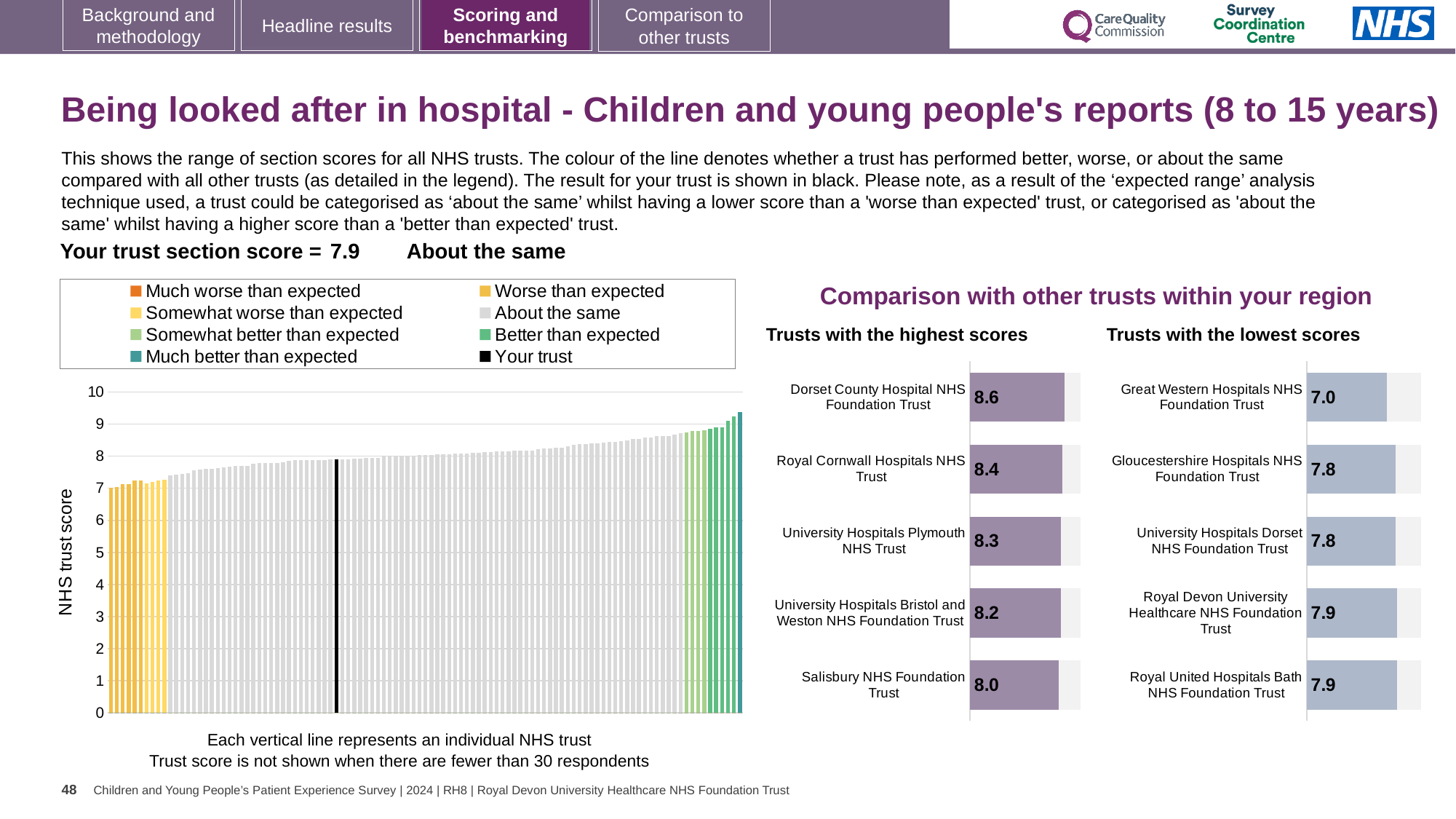
In the 'Trusts with the lowest scores' chart, what is the score for Great Western Hospitals NHS Foundation Trust? 7.0 In the 'Trusts with the highest scores' chart, what is the score for Dorset County Hospital NHS Foundation Trust? 8.6 In the large chart on the left, do the trust scores rise or fall from left to right? Rise What kind of chart is the large chart on the left showing NHS trust scores? Bar chart In the 'Trusts with the lowest scores' chart, which has the larger score: Great Western Hospitals NHS Foundation Trust or Gloucestershire Hospitals NHS Foundation Trust? Gloucestershire Hospitals NHS Foundation Trust In the 'Trusts with the highest scores' chart, which trust has the lowest score? Salisbury NHS Foundation Trust In the 'Trusts with the lowest scores' chart, which trust has the lowest score? Great Western Hospitals NHS Foundation Trust In the 'Trusts with the lowest scores' chart, what is the score for Royal United Hospitals Bath NHS Foundation Trust? 7.9 In the 'Trusts with the highest scores' chart, what is the difference between the scores of Dorset County Hospital NHS Foundation Trust and Salisbury NHS Foundation Trust? 0.6 In the 'Trusts with the highest scores' chart, how many trusts are shown? 5 In the large chart on the left, is the value of the tallest bar greater or less than 9? greater How many entries does the legend of the large chart on the left list? 8